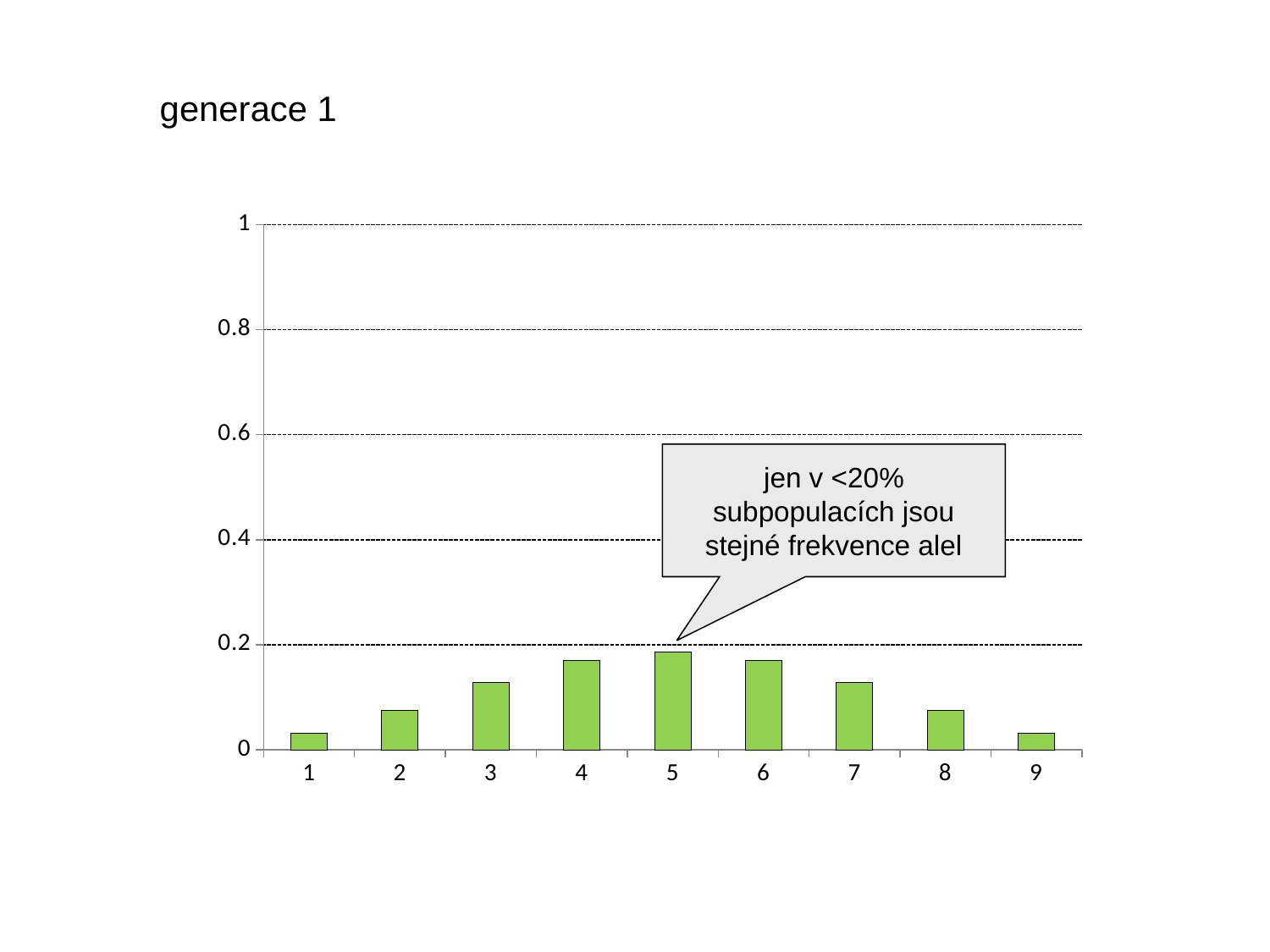
What kind of chart is shown on the slide? bar chart Do the values rise or fall from category 1 to category 5? rise How many categories are shown on the x axis of the chart? 9 Which is larger, the value for category 2 or the value for category 3? category 3 What is the title text shown above the chart on the slide? generace 1 Do the values rise or fall from category 5 to category 9? fall Is the value for category 5 greater or less than 0.2? less Which category has the highest bar in the chart? 5 Which is larger, the value for category 5 or the value for category 1? category 5 Is the value for category 1 greater or less than 0.2? less Is the value for category 3 greater or less than 0.2? less Which is larger, the value for category 7 or the value for category 9? category 7